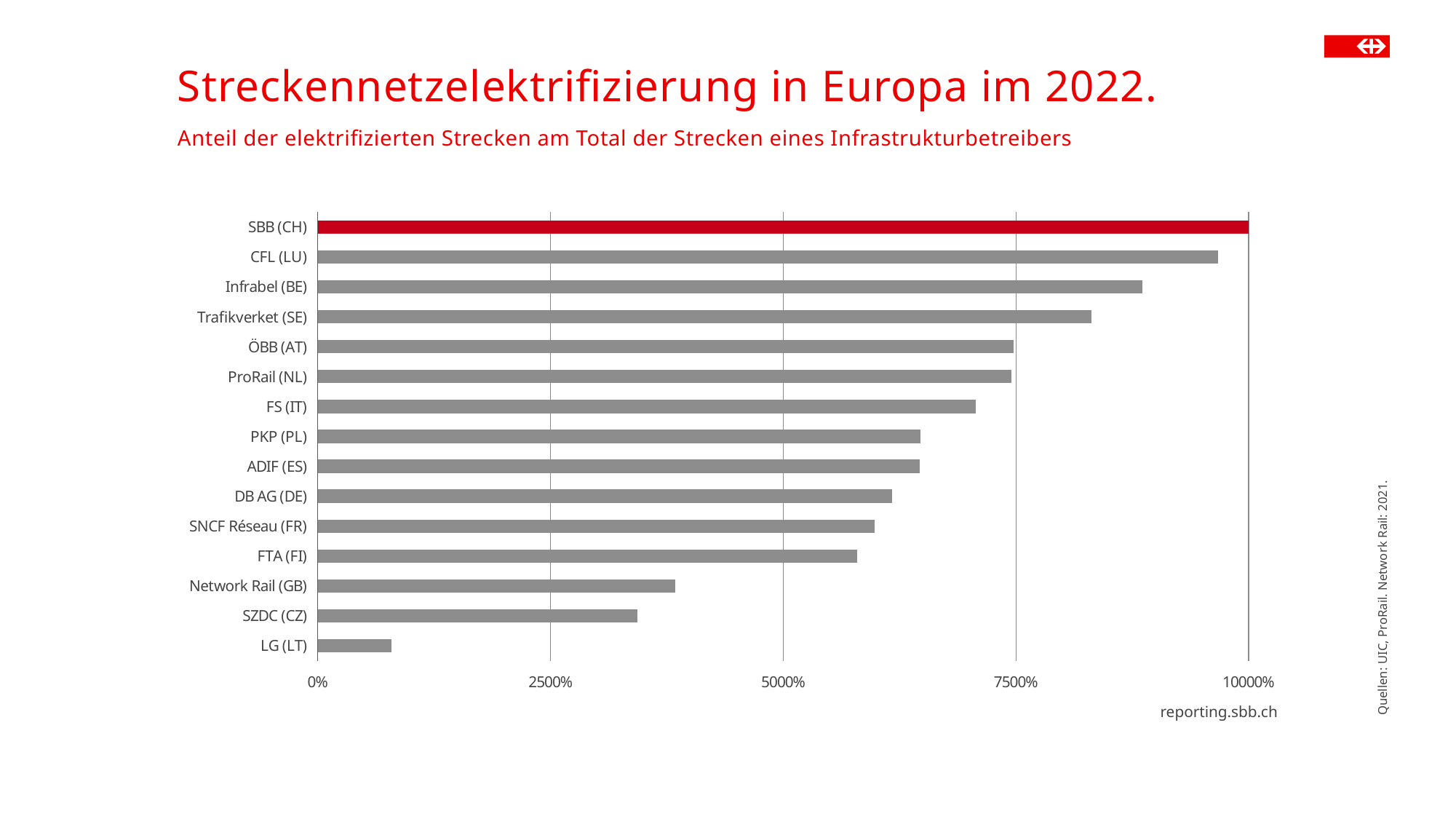
Is the value for Network Rail (GB) greater or less than 5000%? less How many infrastructure operators are shown in the chart? 15 Which infrastructure operator has the highest value in the chart? SBB (CH) Which has the larger value, Infrabel (BE) or Trafikverket (SE)? Infrabel (BE) Is the value for CFL (LU) greater or less than 7500%? greater Is the value for LG (LT) greater or less than 2500%? less What kind of chart is shown on the slide? bar chart What colour is the bar for SBB (CH)? red Which has the larger value, Network Rail (GB) or SZDC (CZ)? Network Rail (GB) Which infrastructure operator has the lowest value in the chart? LG (LT)